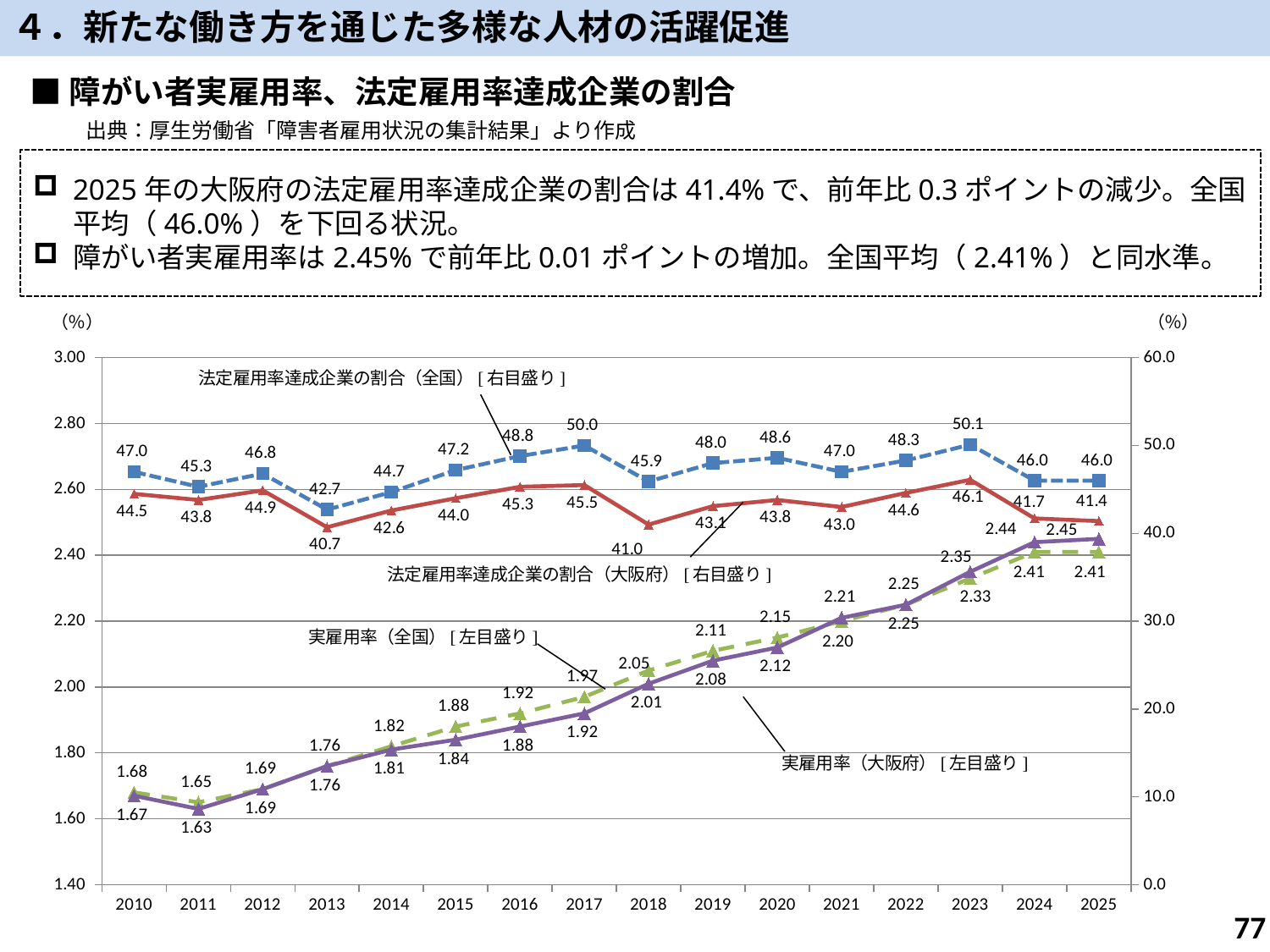
2024年の実雇用率は、全国と大阪府のどちらが高いですか？ 大阪府 2018年の実雇用率（大阪府）の値はいくつですか？ 2.01 2025年の法定雇用率達成企業の割合（大阪府）の値はいくつですか？ 41.4 2025年の法定雇用率達成企業の割合について、全国と大阪府の差は何ポイントですか？ 4.6 法定雇用率達成企業の割合（全国）が最も高いのは何年ですか？ 2023 2023年の法定雇用率達成企業の割合（全国）の値はいくつですか？ 50.1 グラフには何本の系列（線）が描かれていますか？ 4 このグラフの種類は何ですか？ 折れ線グラフ 法定雇用率達成企業の割合（大阪府）が最も低いのは何年ですか？ 2013 実雇用率（大阪府）が最も低いのは何年ですか？ 2011 横軸には何年分のデータ点がありますか？ 16 2010年から2025年にかけて、実雇用率（大阪府）は全体として上昇していますか、下降していますか？ 上昇